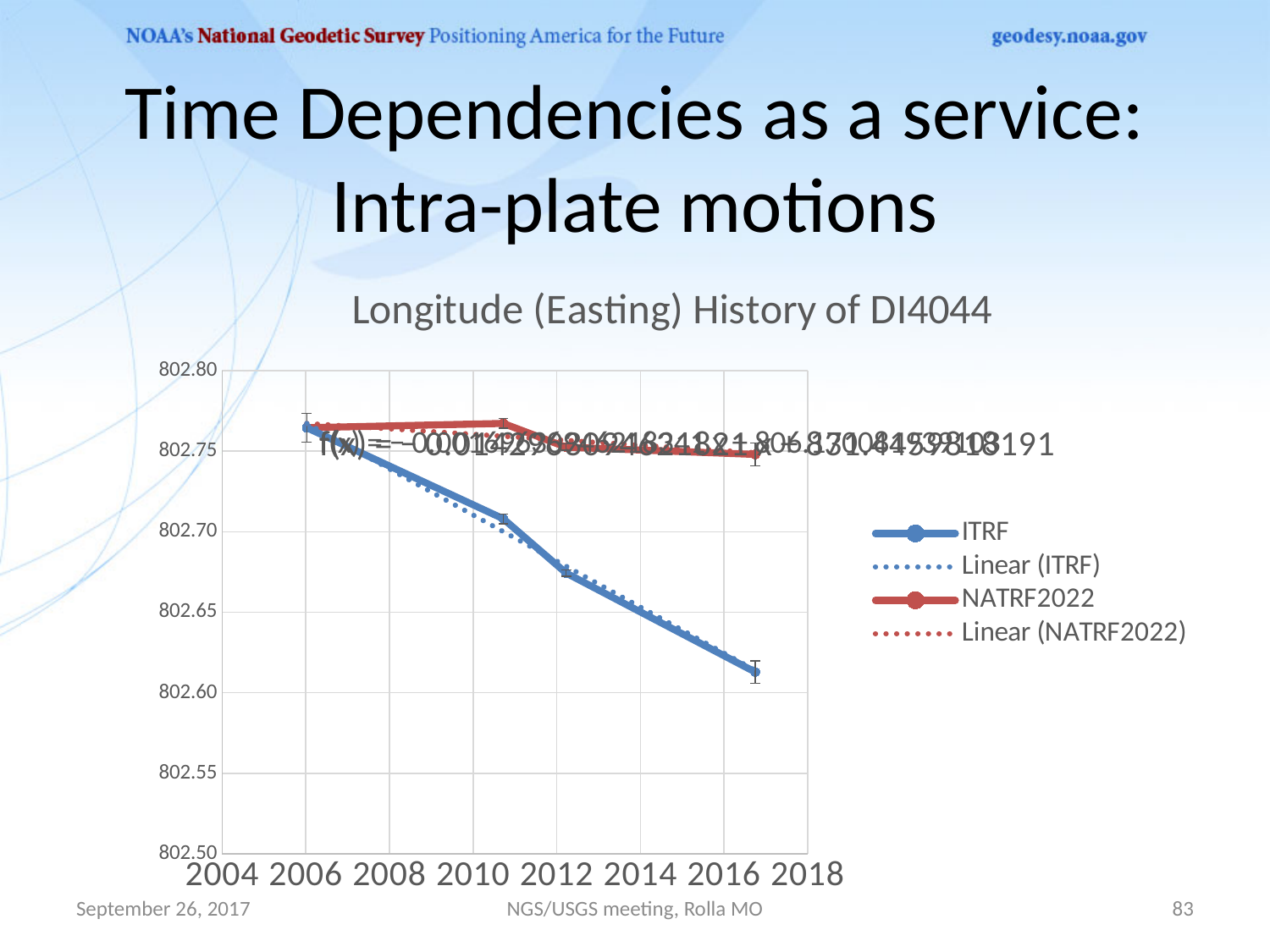
What is the title of the chart? Longitude (Easting) History of DI4044 At 2017, which series has the higher value, ITRF or NATRF2022? NATRF2022 Is the ITRF value at 2017 greater or less than 802.65? less Is the ITRF value at 2012 greater or less than 802.70? less How many data points are plotted for the ITRF series? 4 What kind of chart is shown on the slide? line chart In which year does the ITRF series reach its lowest value? 2017 How many entries does the chart legend list? 4 In which year does the ITRF series reach its highest value? 2006 Do the ITRF values rise or fall from 2006 to 2017? fall Is the NATRF2022 value at 2017 greater or less than 802.70? greater